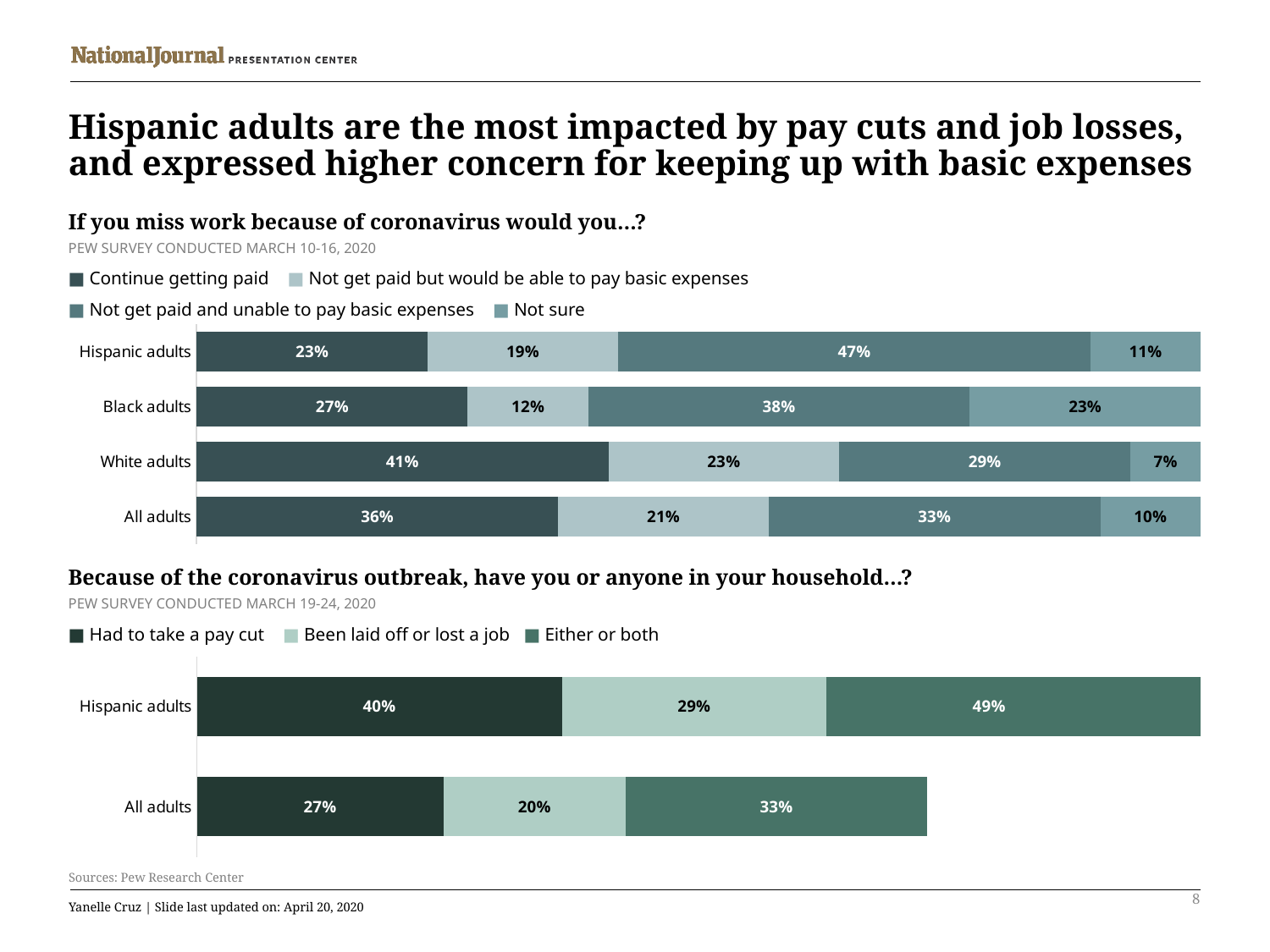
What type of chart is used in the bottom chart on the slide? Bar chart In the chart titled 'If you miss work because of coronavirus would you...?', what percentage of Hispanic adults said they would not get paid and be unable to pay basic expenses? 47% In the chart titled 'Because of the coronavirus outbreak, have you or anyone in your household...?', what is the difference between Hispanic adults and All adults for 'Had to take a pay cut'? 13 percentage points In the chart titled 'If you miss work because of coronavirus would you...?', what is the difference between the 'Not sure' share for Black adults and for White adults? 16 percentage points In the chart titled 'If you miss work because of coronavirus would you...?', what percentage of White adults said they would continue getting paid? 41% In the chart titled 'If you miss work because of coronavirus would you...?', how many series does the legend list? 4 In the chart titled 'Because of the coronavirus outbreak, have you or anyone in your household...?', how many series does the legend list? 3 In the chart titled 'Because of the coronavirus outbreak, have you or anyone in your household...?', what percentage of Hispanic adults said 'Either or both'? 49% In the chart titled 'If you miss work because of coronavirus would you...?', which group has the lowest share saying 'Not sure'? White adults In the chart titled 'If you miss work because of coronavirus would you...?', which group has the highest share saying they would continue getting paid? White adults In the chart titled 'If you miss work because of coronavirus would you...?', how many groups are shown? 4 In the chart titled 'Because of the coronavirus outbreak, have you or anyone in your household...?', which is larger: the 'Been laid off or lost a job' share for Hispanic adults or for All adults? Hispanic adults